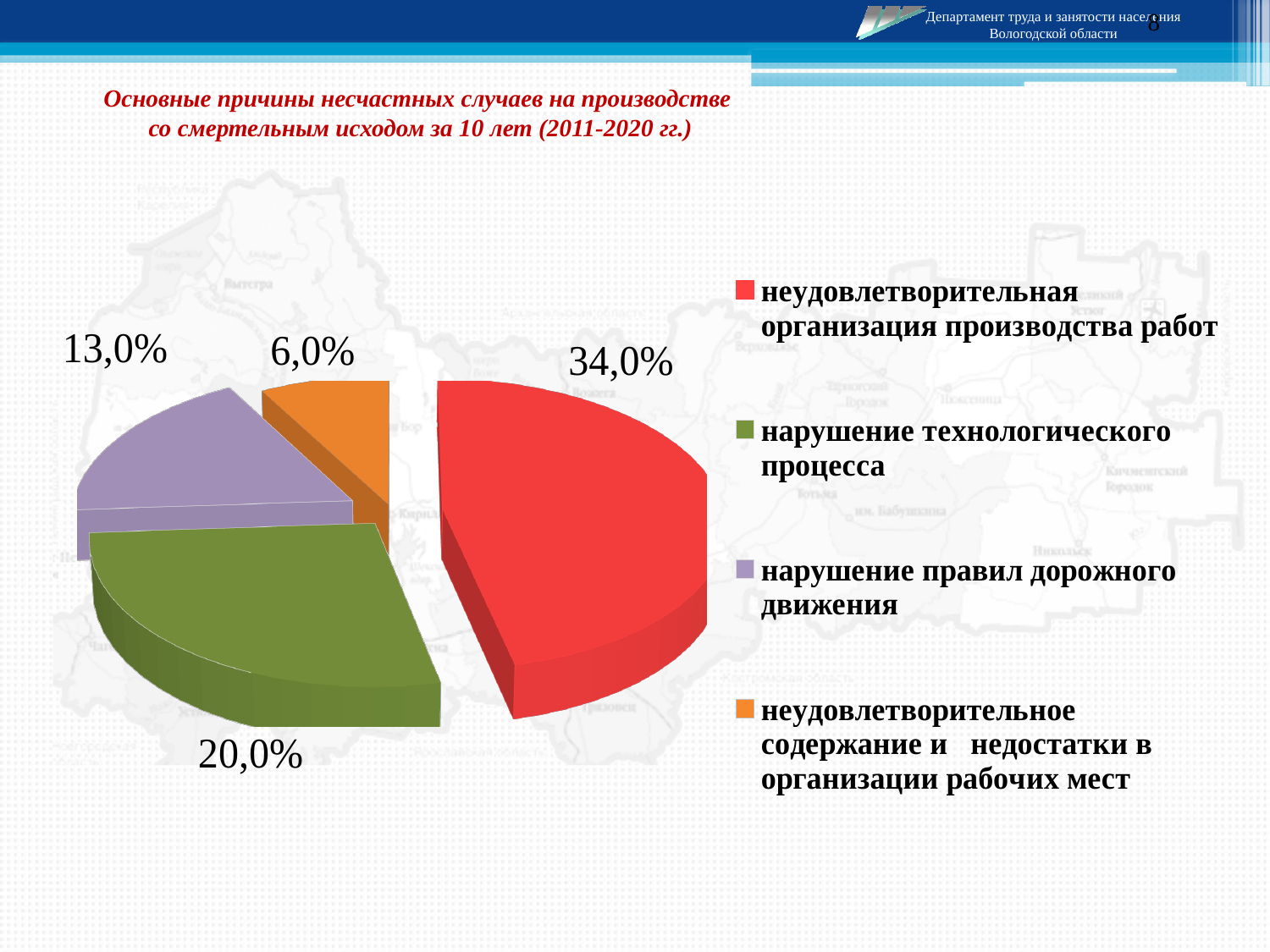
What share of the pie is labelled for "неудовлетворительная организация производства работ"? 34,0% What colour is the slice for "нарушение технологического процесса"? green How many entries does the legend list? 4 What is the difference between the values for "неудовлетворительная организация производства работ" and "нарушение технологического процесса"? 14,0% Which cause has the largest slice of the pie? неудовлетворительная организация производства работ Which is larger: the value for "нарушение правил дорожного движения" or for "неудовлетворительное содержание и недостатки в организации рабочих мест"? нарушение правил дорожного движения Which cause has the smallest slice of the pie? неудовлетворительное содержание и недостатки в организации рабочих мест What value is shown for "нарушение технологического процесса"? 20,0% What value is shown for "нарушение правил дорожного движения"? 13,0% What value is shown for "неудовлетворительное содержание и недостатки в организации рабочих мест"? 6,0% What kind of chart is shown on the slide? pie chart How many slices does the pie chart have? 4